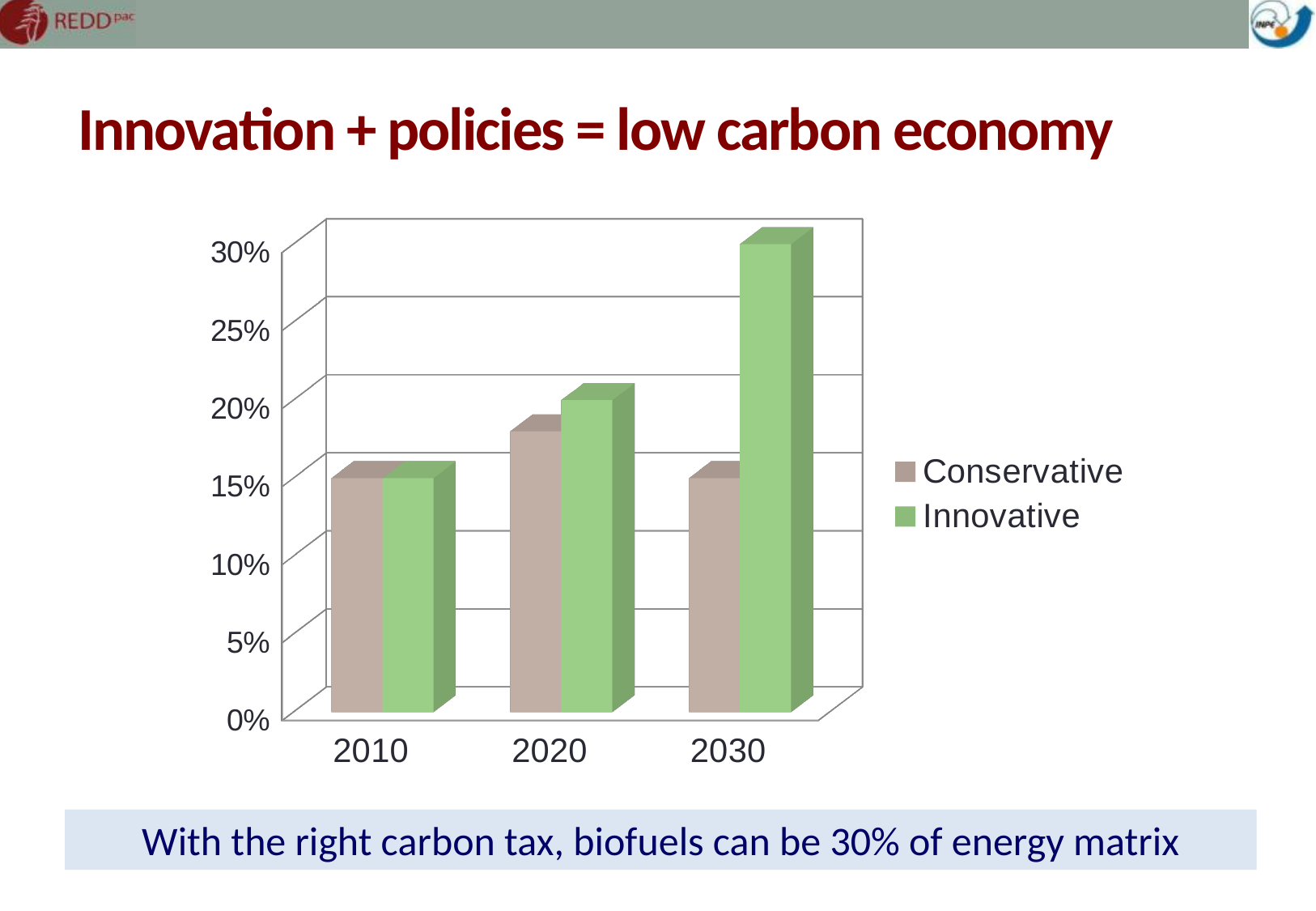
Do the Innovative values rise or fall from 2010 to 2030? rise What kind of chart is shown on the slide? bar chart Which series is shown in green? Innovative Is the value for Innovative in 2030 greater or less than 25%? greater What is the value for Innovative in 2020? 20% In 2030, which series has the larger value, Conservative or Innovative? Innovative How many years are shown on the x axis? 3 Is the value for Conservative in 2020 greater or less than 20%? less How many series does the legend list? 2 What is the value for Innovative in 2030? 30% Is the value for Conservative in 2020 greater or less than 15%? greater In which year is the Innovative value highest? 2030